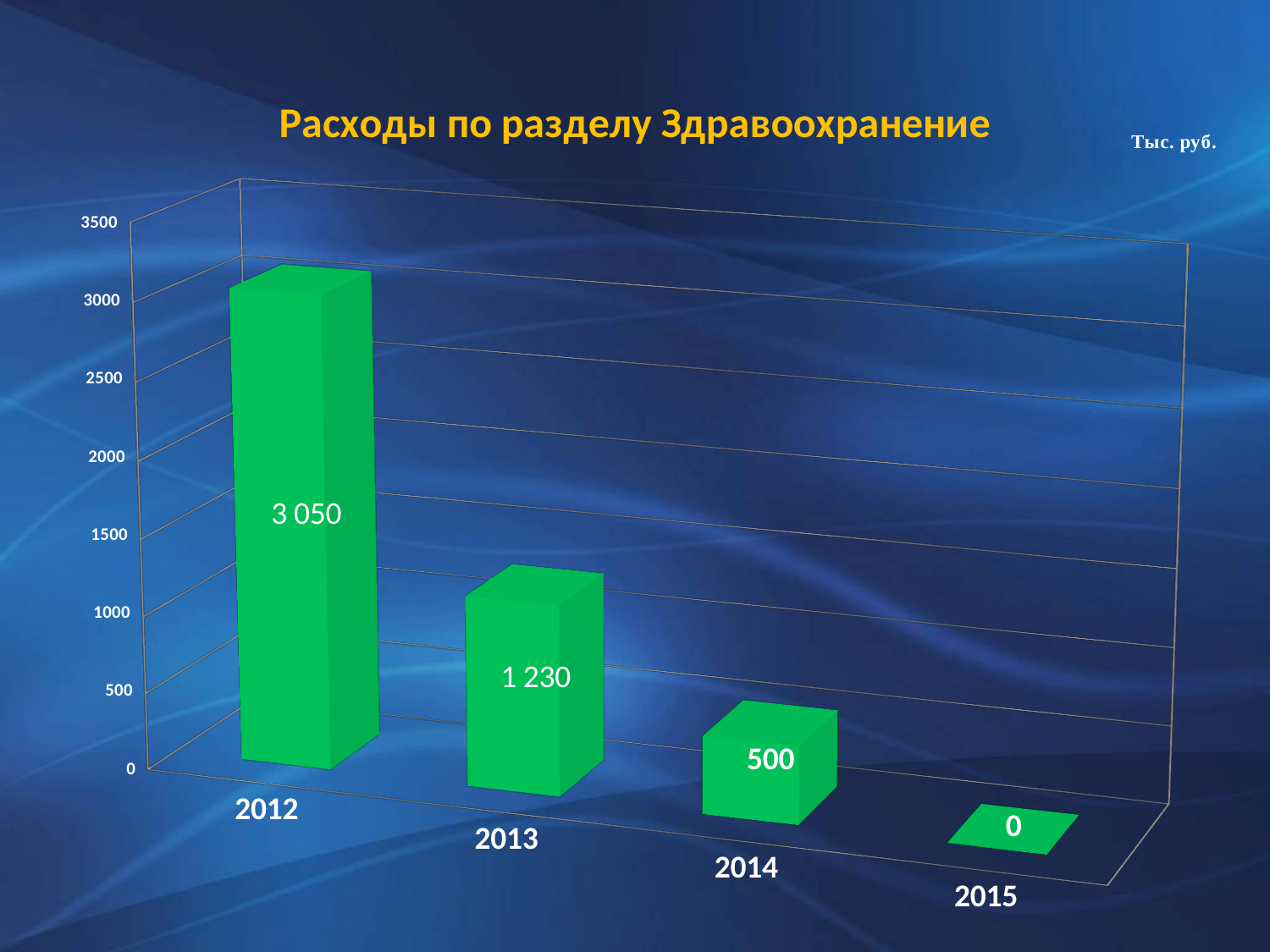
How many years are shown on the chart? 4 What is the value for 2013? 1 230 Which year has the highest value? 2012 Which is larger, the value for 2013 or the value for 2014? 2013 Do the values rise or fall from 2012 to 2015? fall What kind of chart is this? bar chart What is the value for 2014? 500 What is the value for 2012? 3 050 What is the difference between the values for 2012 and 2013? 1 820 What is the difference between the values for 2013 and 2014? 730 Which year has the lowest value? 2015 What is the value for 2015? 0